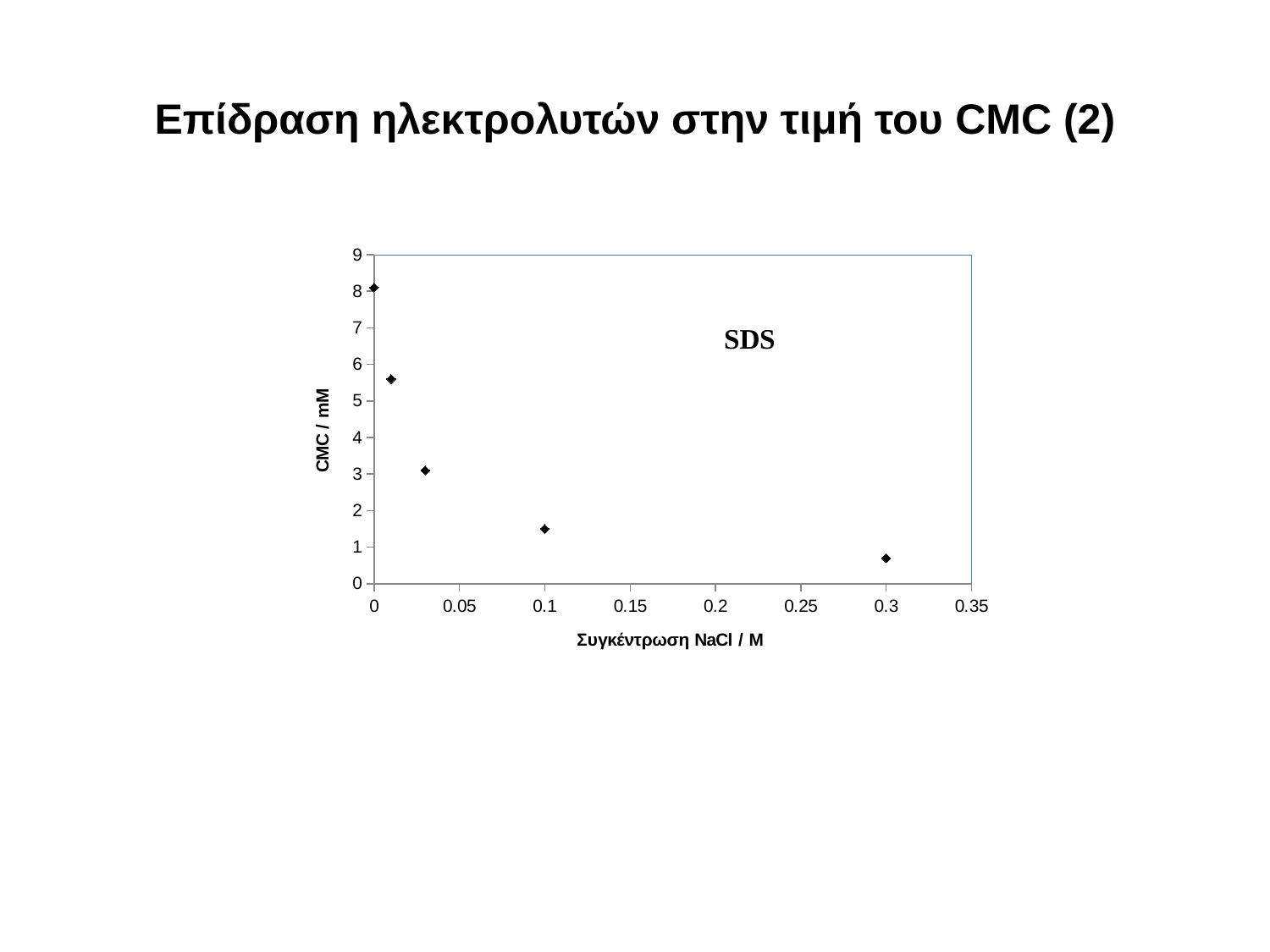
Is the CMC value at 0.1 M NaCl greater or less than 2 mM? less How many data points are plotted in the chart? 5 What is the label on the y axis of the chart? CMC / mM What surfactant name is written inside the plot area? SDS At which NaCl concentration is the CMC value highest? 0 M Is the CMC value at 0.3 M NaCl greater or less than 1 mM? less Which has the larger CMC value: the point at 0.1 M NaCl or the point at 0.3 M NaCl? 0.1 M NaCl What kind of chart is shown on the slide? scatter plot Does the CMC value rise or fall as the NaCl concentration increases along the x axis? fall At which NaCl concentration is the CMC value lowest? 0.3 M Is the CMC value at 0 M NaCl greater or less than 7 mM? greater